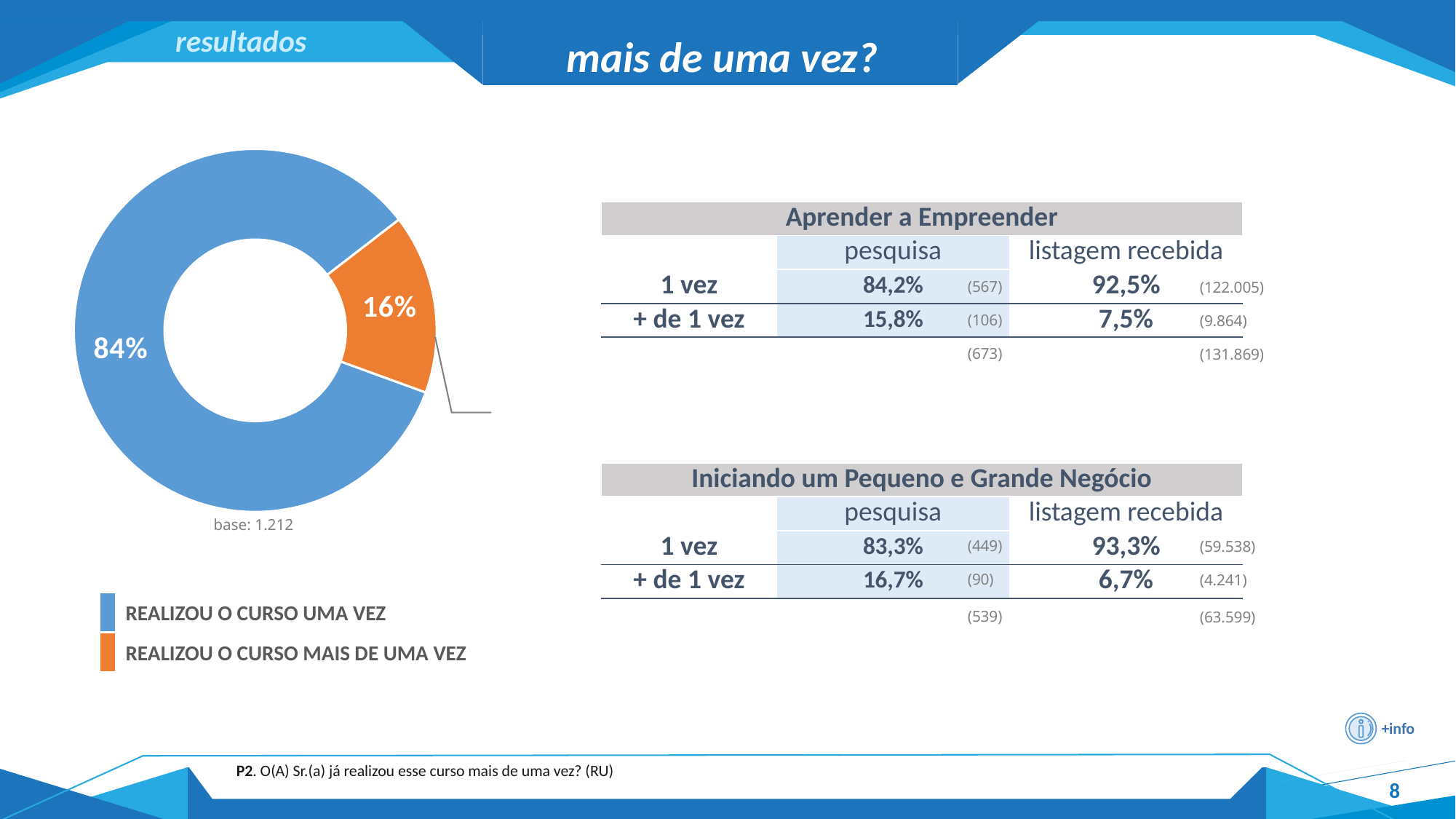
Which is larger in the donut chart: the share for 'REALIZOU O CURSO UMA VEZ' or for 'REALIZOU O CURSO MAIS DE UMA VEZ'? REALIZOU O CURSO UMA VEZ What kind of chart is shown on the left of the slide? Donut (pie) chart What colour is the slice for 'REALIZOU O CURSO MAIS DE UMA VEZ' in the donut chart? Orange Which slice of the donut chart is the largest? REALIZOU O CURSO UMA VEZ Which slice of the donut chart is the smallest? REALIZOU O CURSO MAIS DE UMA VEZ What share of the donut chart is labelled for 'REALIZOU O CURSO UMA VEZ'? 84% What base (number of respondents) is shown under the donut chart? base: 1.212 How many entries does the legend of the donut chart list? 2 How many slices does the donut chart have? 2 Is the share for 'REALIZOU O CURSO MAIS DE UMA VEZ' in the donut chart greater or less than 50%? less What share of the donut chart is labelled for 'REALIZOU O CURSO MAIS DE UMA VEZ'? 16% What is the difference in percentage points between the two slices of the donut chart? 68 percentage points